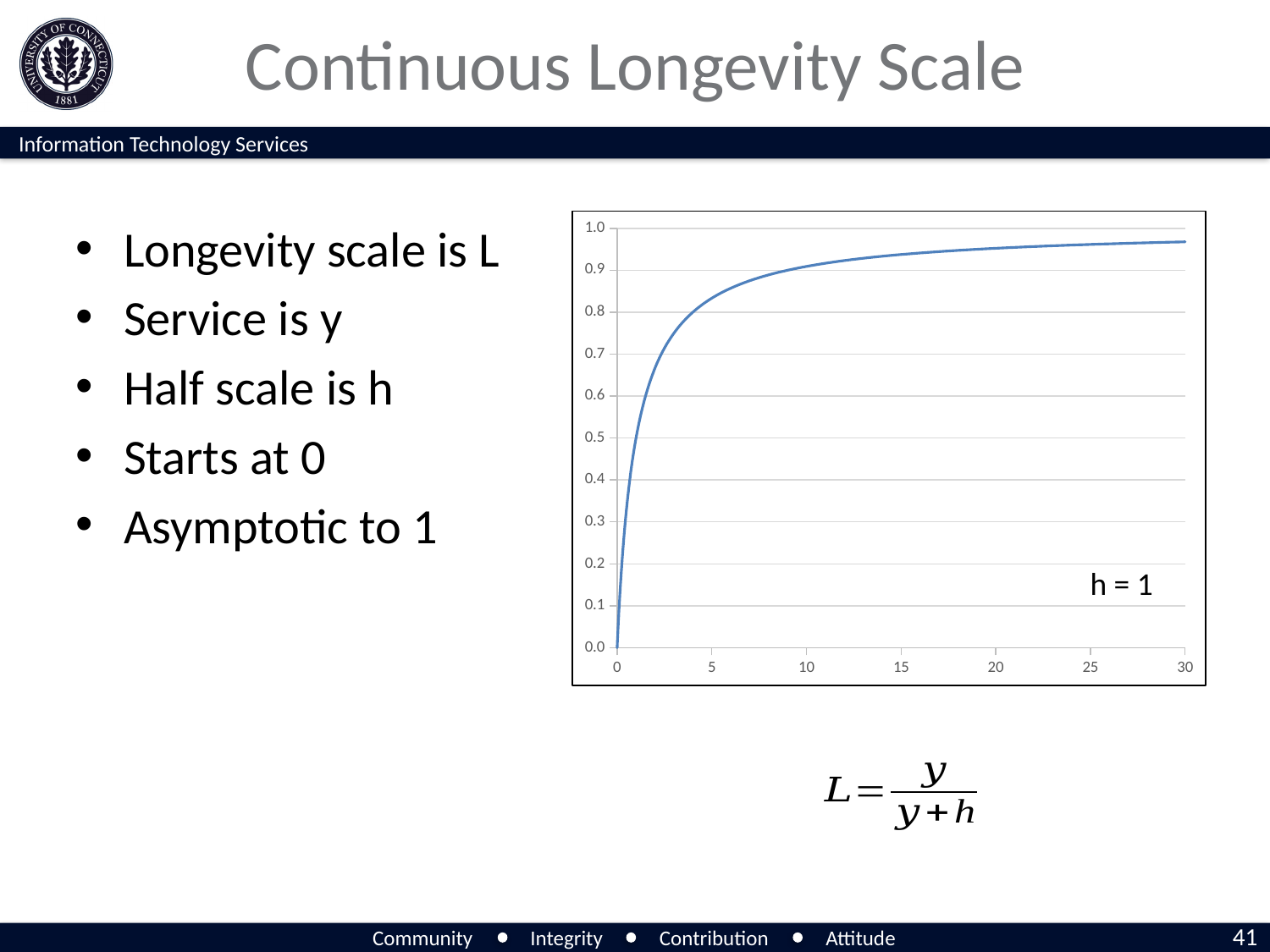
Does the plotted value rise or fall as the x axis increases from 0 to 30? rise Is the plotted value at x = 20 greater or less than 0.9? greater Is the plotted value at x = 10 greater or less than 0.8? greater Which is larger, the plotted value at x = 5 or at x = 25? x = 25 Is the plotted value at x = 5 greater or less than 0.7? greater What is the largest value shown on the x axis? 30 What kind of chart is shown on the slide? line chart What is the highest value shown on the y axis? 1.0 What value of h is annotated on the chart? h = 1 What is the plotted value at x = 0? 0.0